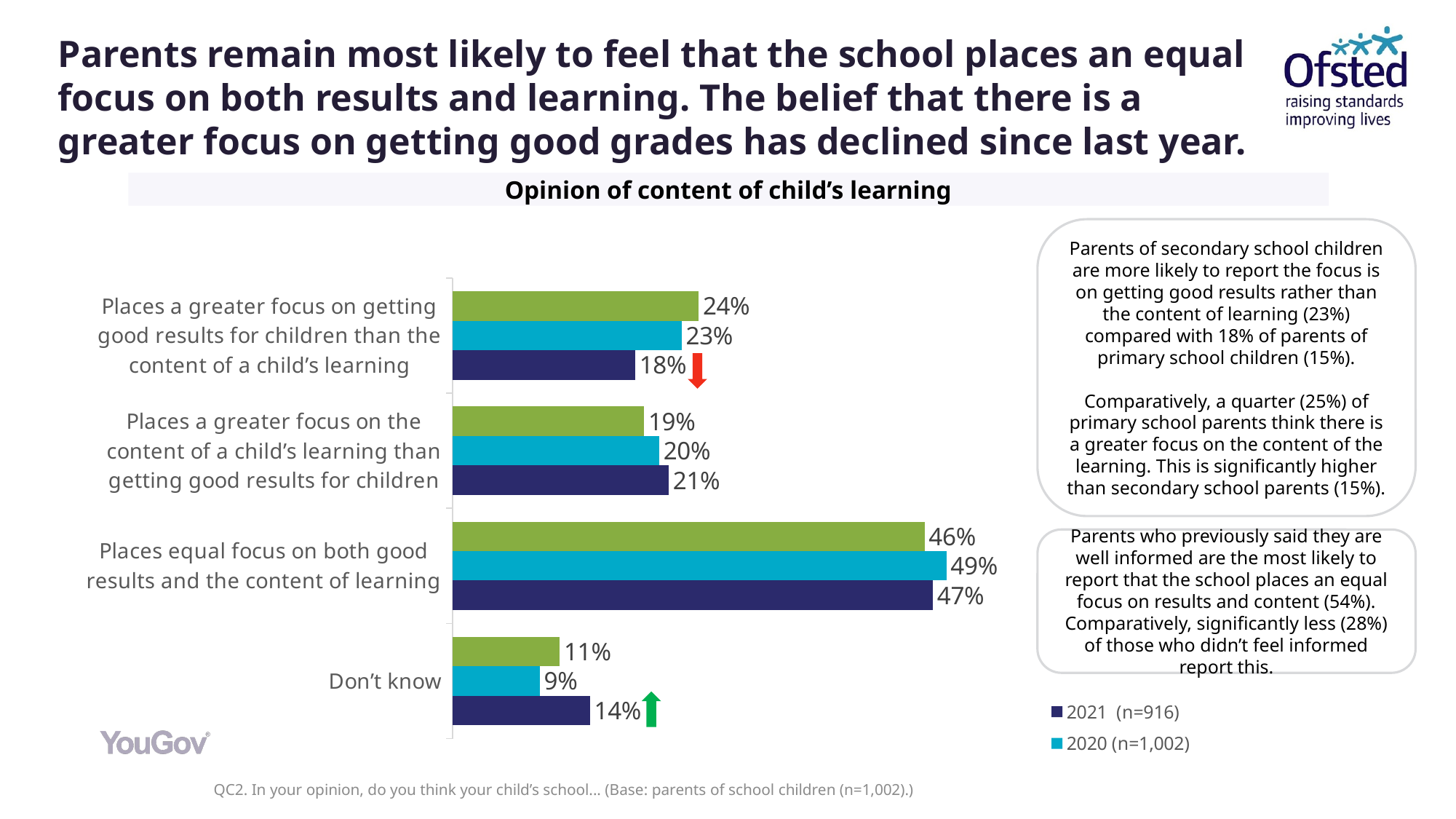
What is the 2020 value for 'Don't know'? 9% What is the 2021 value for 'Places equal focus on both good results and the content of learning'? 47% How many series does the legend list? 2 What is the difference between the 2020 and 2021 values for 'Places a greater focus on getting good results for children than the content of a child's learning'? 5% What is the title of the chart? Opinion of content of child's learning How many categories are shown on the chart? 4 What is the 2021 value for 'Places a greater focus on getting good results for children than the content of a child's learning'? 18% What is the 2020 value for 'Places a greater focus on the content of a child's learning than getting good results for children'? 20% Which is larger for 'Don't know': the 2021 value or the 2020 value? 2021 Which category has the highest 2021 value? Places equal focus on both good results and the content of learning What kind of chart is shown on the slide? bar chart Which category has the lowest 2020 value? Don't know